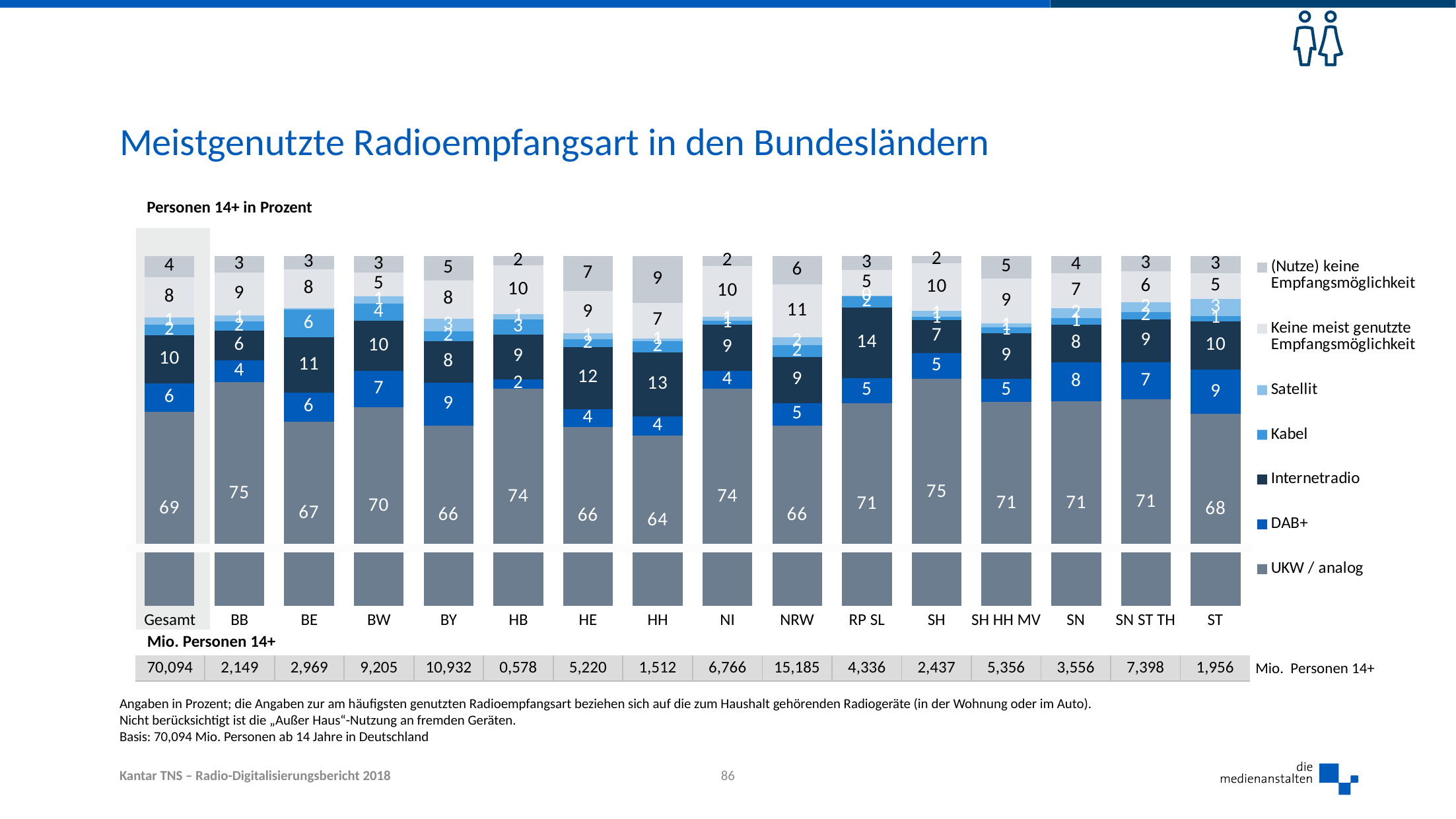
What kind of chart is shown? Stacked bar chart Which category has the highest Internetradio value? RP SL What is the UKW / analog value for HH? 64 How many categories are shown on the x axis? 16 Which category has the highest value for '(Nutze) keine Empfangsmöglichkeit'? HH What is the difference between the Internetradio values for HH and BB? 7 What is the 'Mio. Personen 14+' value shown for NRW? 15,185 What is the Internetradio value for RP SL? 14 Which category has the lowest UKW / analog value? HH Which has the larger DAB+ value, BY or HB? BY What is the DAB+ value for BY? 9 How many series does the legend list? 7